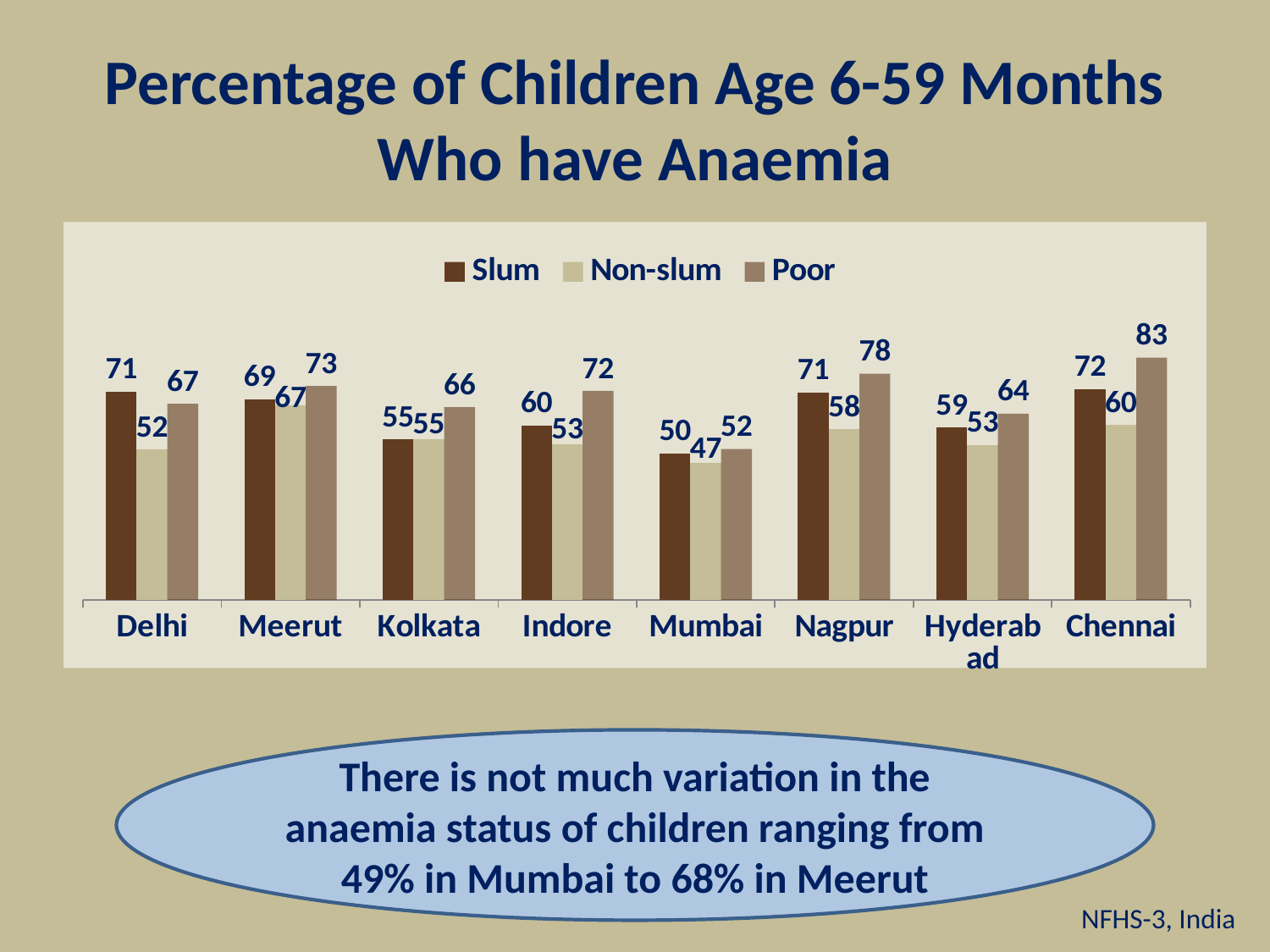
What is the difference between the Poor and Non-slum values in Delhi? 15 What is the value for Poor in Chennai? 83 What is the value for Slum in Delhi? 71 What is the value for Non-slum in Mumbai? 47 What is the difference between the Slum values for Chennai and Mumbai? 22 How many cities are shown on the x axis? 8 Which city has the lowest value for the Slum series? Mumbai What kind of chart is shown on the slide? Bar chart What are the three series listed in the legend? Slum, Non-slum, Poor Which is larger in Nagpur, the Slum value or the Poor value? Poor Which city has the highest value for the Poor series? Chennai How many series does the legend list? 3